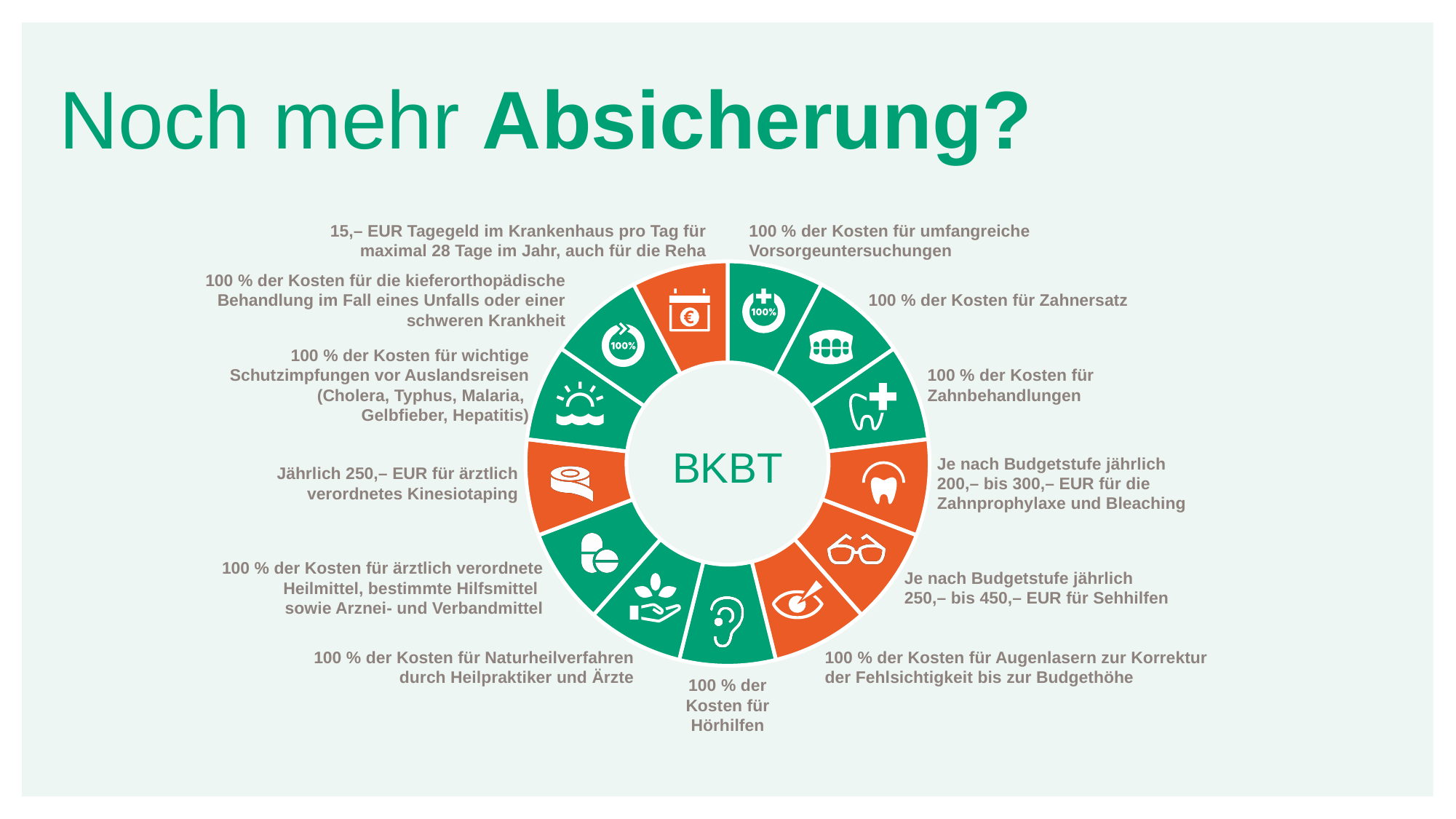
How many segments does the ring diagram have? 13 What annual amount is listed for medically prescribed Kinesiotaping? 250,– EUR For how many days per year at most is the hospital daily allowance paid? 28 Tage What text is shown in the centre of the ring diagram? BKBT What percentage of the costs for Hörhilfen is covered according to the slide? 100 % What annual range is listed for Sehhilfen depending on the budget level? 250,– bis 450,– EUR What annual range is listed for Zahnprophylaxe und Bleaching depending on the budget level? 200,– bis 300,– EUR What daily hospital allowance (Tagegeld im Krankenhaus) is listed on the slide? 15,– EUR How many segments of the ring are coloured orange? 5 What percentage of the costs for Zahnersatz is covered according to the slide? 100 %